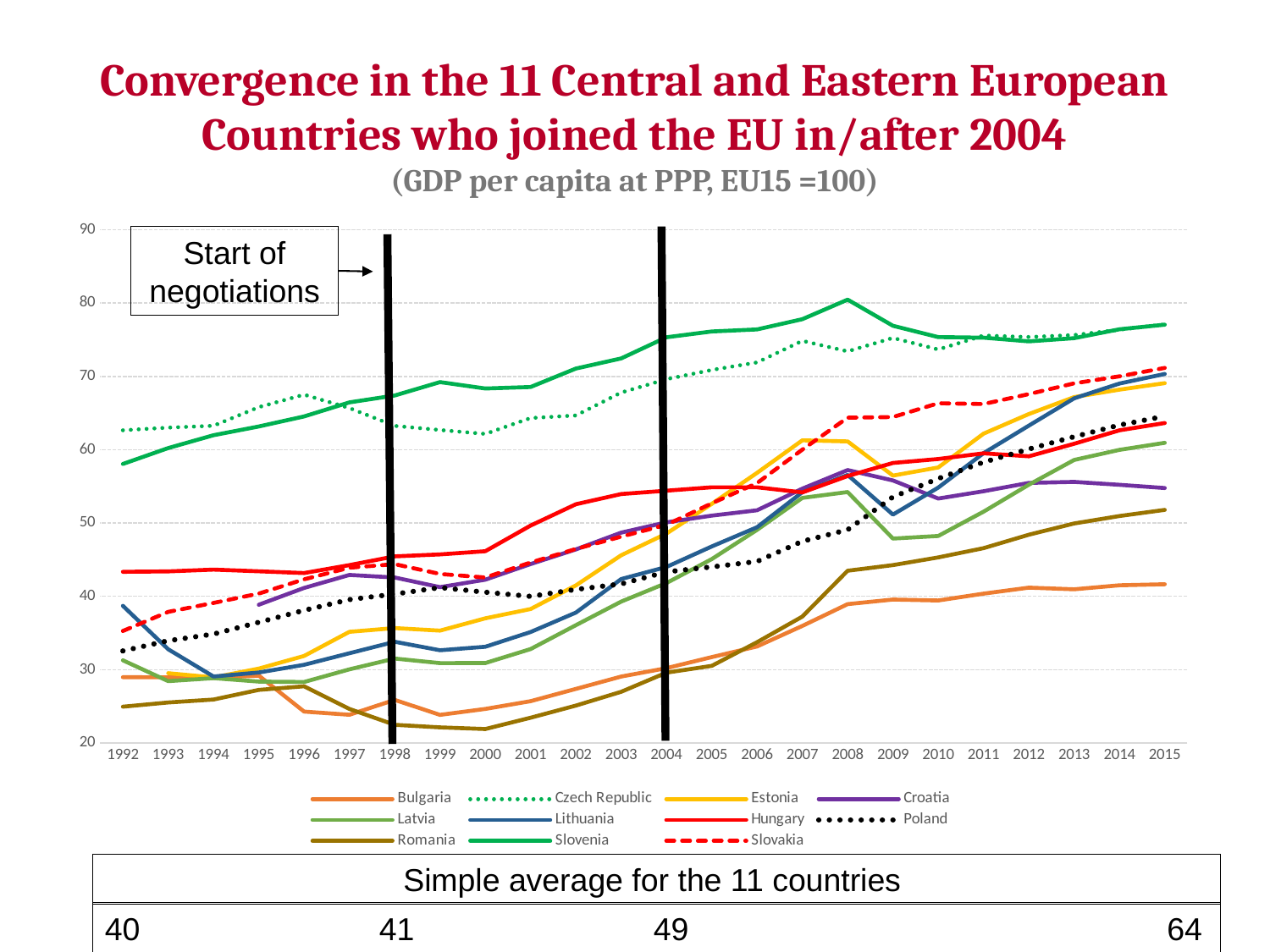
Is the value for Romania in 2000 greater or less than 30? less How many countries (series) does the legend list? 11 Which is larger in 2008, the value for Slovenia or the value for Bulgaria? Slovenia How many years are shown along the x axis? 24 Is the value for Bulgaria in 2015 greater or less than 50? less Is the value for Slovenia in 2015 greater or less than 70? greater What kind of chart is shown on the slide? line chart Does the value for Slovenia rise or fall overall from 1992 to 2015? rise What does the text box with the arrow pointing to the first vertical black line say? Start of negotiations Which country has the highest value in 1992? Czech Republic Which country has the lowest value in 2015? Bulgaria